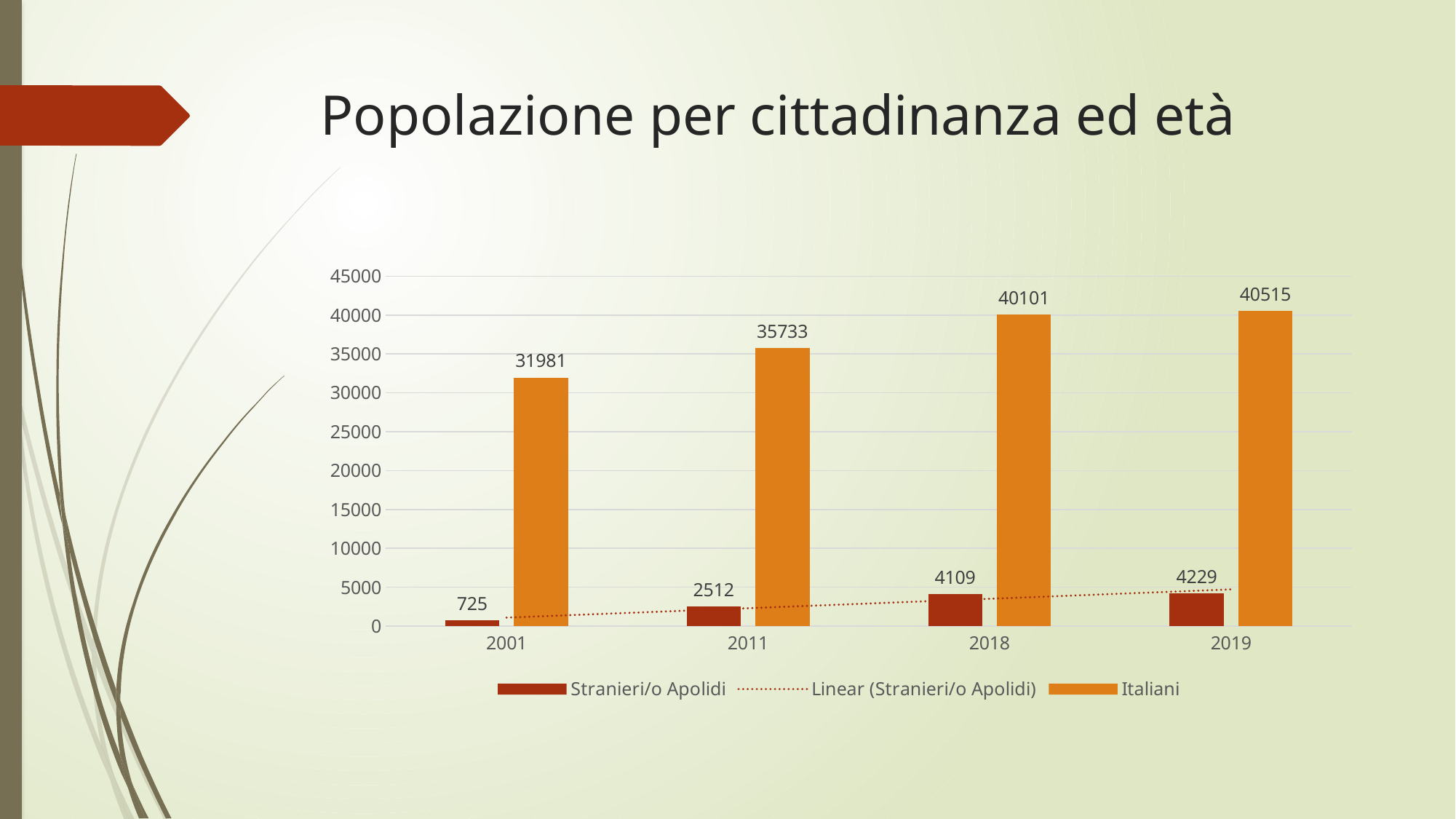
In which year is the Italiani value lowest? 2001 How many entries does the legend list? 3 What is the value for Italiani in 2019? 40515 Which is larger, the Italiani value in 2018 or in 2011? 2018 What is the difference between the Stranieri/o Apolidi values for 2019 and 2018? 120 Do the Italiani values rise or fall from 2001 to 2019? Rise What is the value for Stranieri/o Apolidi in 2001? 725 How many years are shown on the x axis? 4 What kind of chart is shown on the slide? Bar chart What is the value for Stranieri/o Apolidi in 2018? 4109 In which year is the Stranieri/o Apolidi value highest? 2019 What is the difference between the Italiani values for 2011 and 2001? 3752